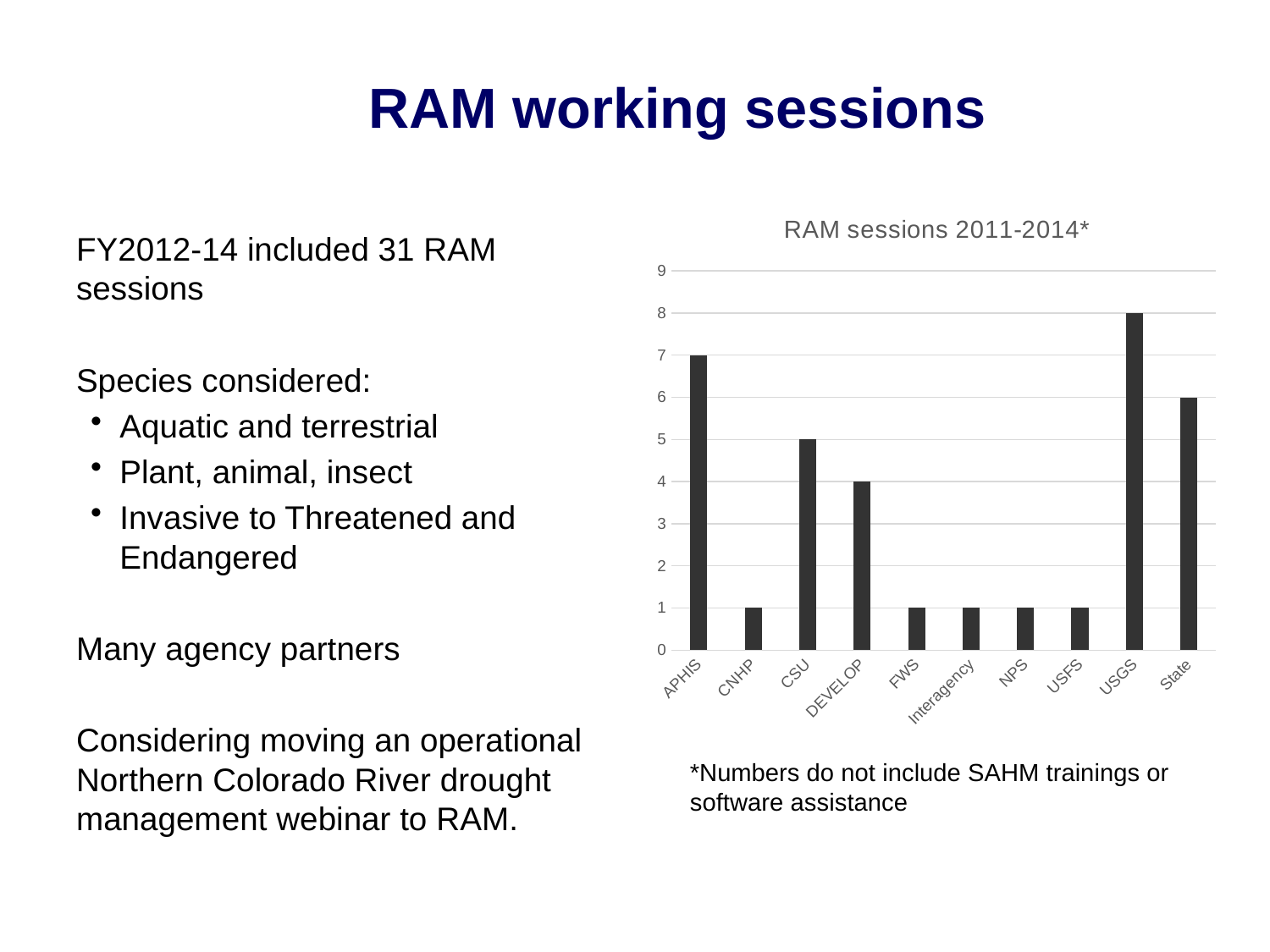
How many RAM sessions does the chart show for CSU? 5 How many RAM sessions does the chart show for APHIS? 7 How many RAM sessions does the chart show for DEVELOP? 4 What is the title of the chart? RAM sessions 2011-2014* What is the difference between the number of RAM sessions for USGS and for CSU? 3 What kind of chart is shown on the slide? Bar chart How many RAM sessions does the chart show for State? 6 How many RAM sessions does the chart show for USGS? 8 How many agency categories are shown on the x axis of the chart? 10 Is the value for DEVELOP greater or less than 5? less Which has more RAM sessions in the chart, APHIS or State? APHIS Which agency has the highest number of RAM sessions in the chart? USGS